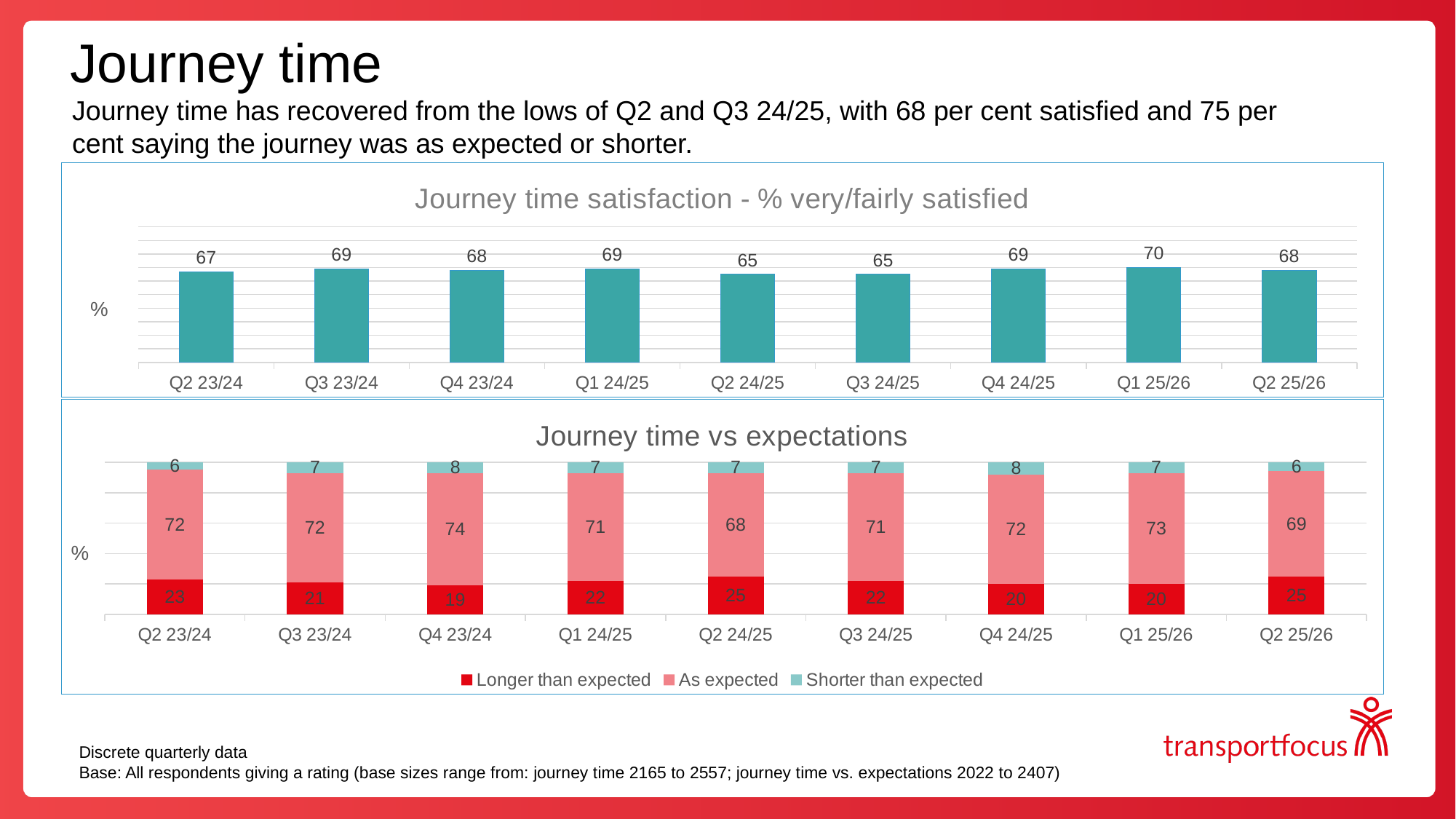
In the 'Journey time vs expectations' chart, which quarter has the lowest 'Longer than expected' value? Q4 23/24 What type of chart is the 'Journey time satisfaction - % very/fairly satisfied' chart? Bar chart How many series does the legend of the 'Journey time vs expectations' chart list? 3 In the 'Journey time vs expectations' chart, what is the total of the stacked bar for Q2 25/26? 100 In the 'Journey time satisfaction - % very/fairly satisfied' chart, what is the value for Q1 25/26? 70 In the 'Journey time vs expectations' chart, is the 'As expected' value larger for Q1 25/26 or Q2 24/25? Q1 25/26 In the 'Journey time satisfaction - % very/fairly satisfied' chart, how many quarters are shown? 9 In the 'Journey time vs expectations' chart, which series is shown in the darkest red colour? Longer than expected In the 'Journey time vs expectations' chart, what is the 'Longer than expected' value for Q2 25/26? 25 In the 'Journey time satisfaction - % very/fairly satisfied' chart, what is the difference between Q1 25/26 and Q2 24/25? 5 In the 'Journey time vs expectations' chart, what is the 'As expected' value for Q4 23/24? 74 In the 'Journey time satisfaction - % very/fairly satisfied' chart, which quarter has the highest value? Q1 25/26